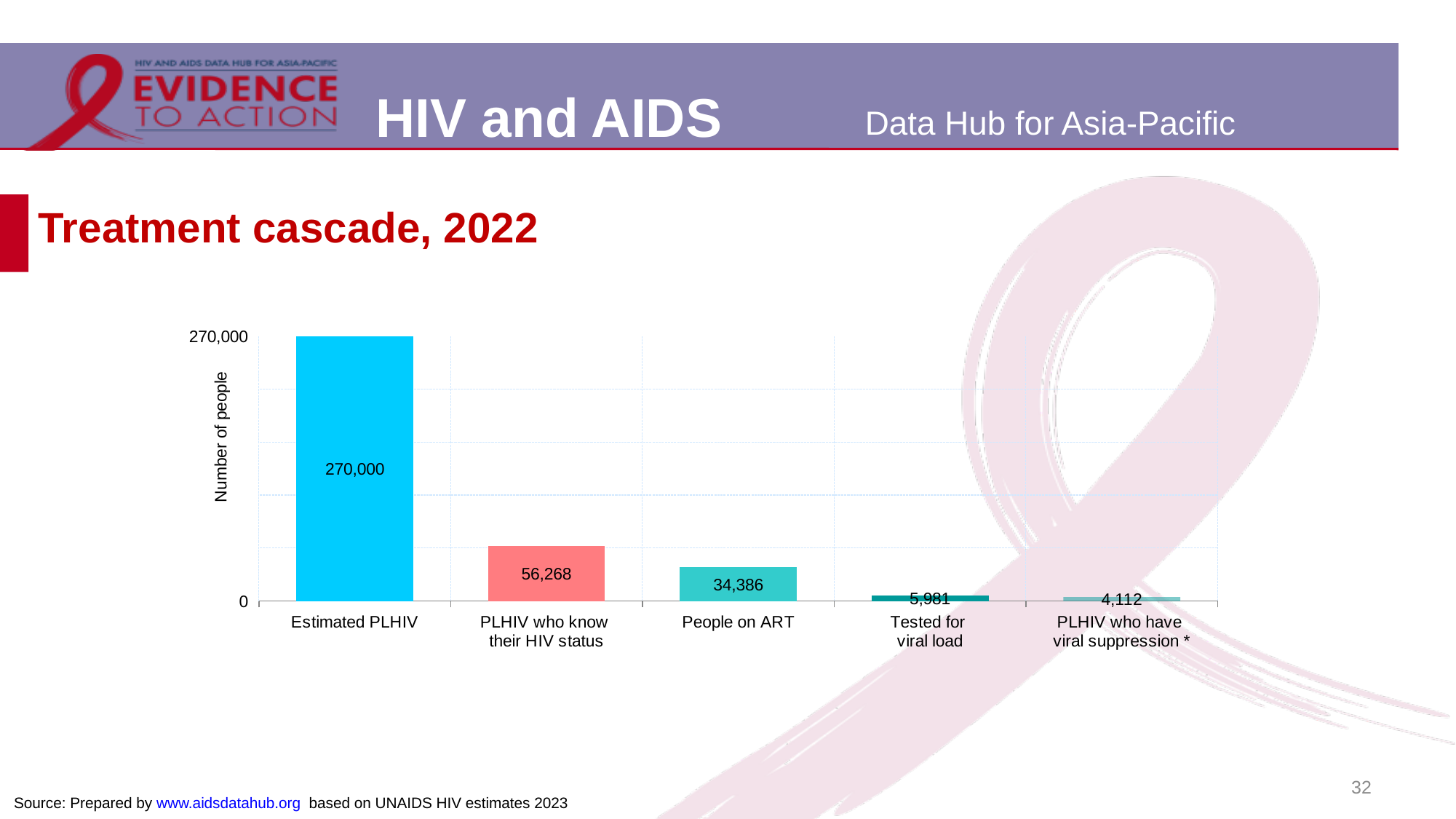
What kind of chart is shown on the slide? Bar chart How many categories are shown on the chart? 5 What is the difference between PLHIV who know their HIV status and People on ART? 21,882 Which category has the highest value? Estimated PLHIV What is the value for Estimated PLHIV? 270,000 Which is larger: Tested for viral load or PLHIV who have viral suppression? Tested for viral load What is the value for PLHIV who have viral suppression? 4,112 What is the value for People on ART? 34,386 What is the title of the chart? Treatment cascade, 2022 Which category has the lowest value? PLHIV who have viral suppression What is the value for PLHIV who know their HIV status? 56,268 What is the value for Tested for viral load? 5,981